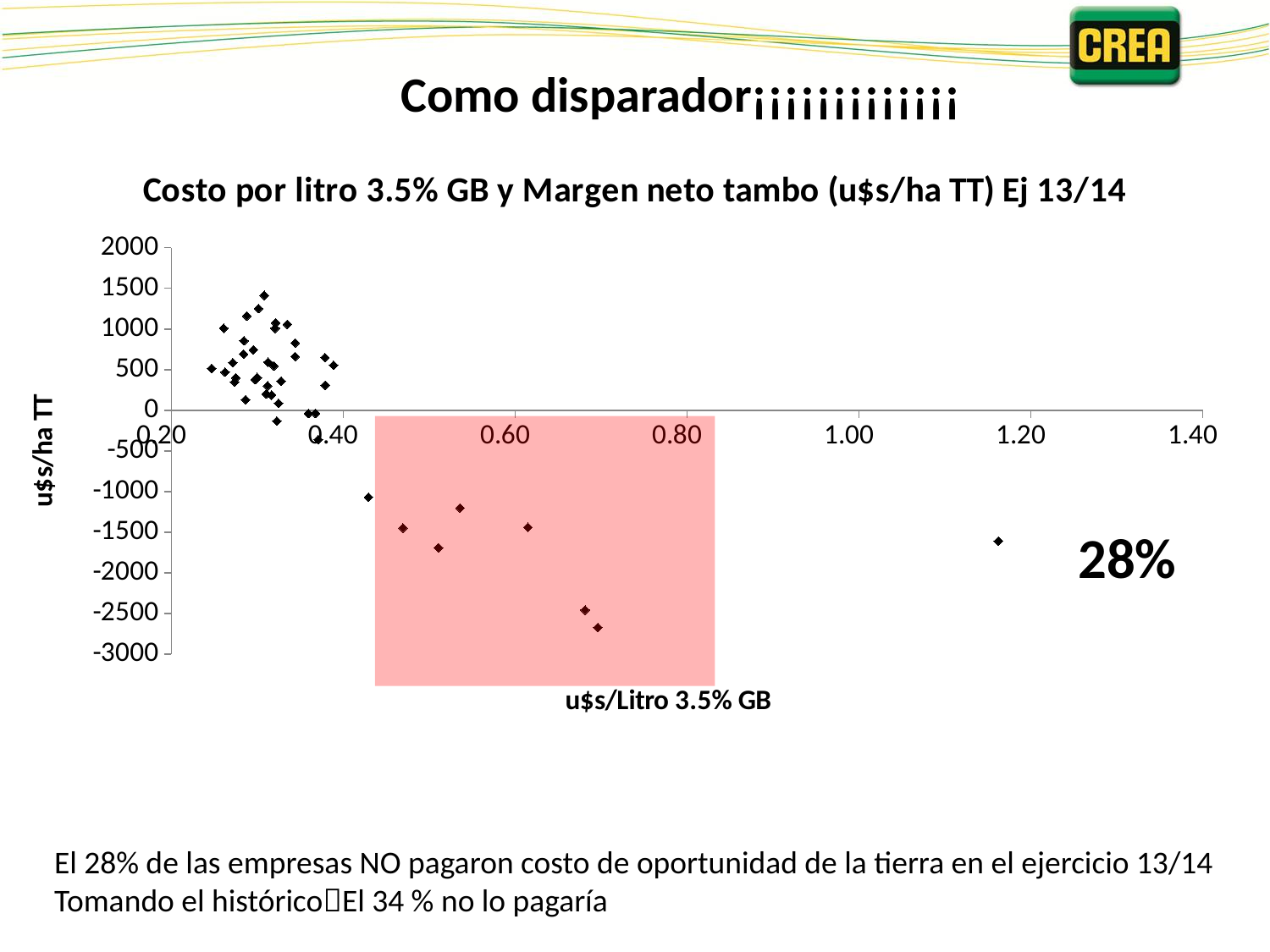
What percentage is printed as an annotation on the right side of the chart? 28% What is the smallest value shown on the horizontal axis of the chart? 0.20 As the horizontal-axis value (cost per litre) increases, do the plotted margin values generally rise or fall? fall Is the vertical-axis value of the lowest point on the chart greater or less than -2500? less What is the largest value shown on the horizontal axis of the chart? 1.40 Is the vertical-axis value of the point with the largest horizontal-axis value (near 1.20) greater or less than -1000? less What is the lowest value shown on the vertical axis of the chart? -3000 What is the label of the horizontal axis of the chart? u$s/Litro 3.5% GB What kind of chart is shown on the slide? Scatter chart Is the vertical-axis value of the highest point on the chart greater or less than 1000? greater What is the highest value shown on the vertical axis of the chart? 2000 What is the title of the chart? Costo por litro 3.5% GB y Margen neto tambo (u$s/ha TT) Ej 13/14